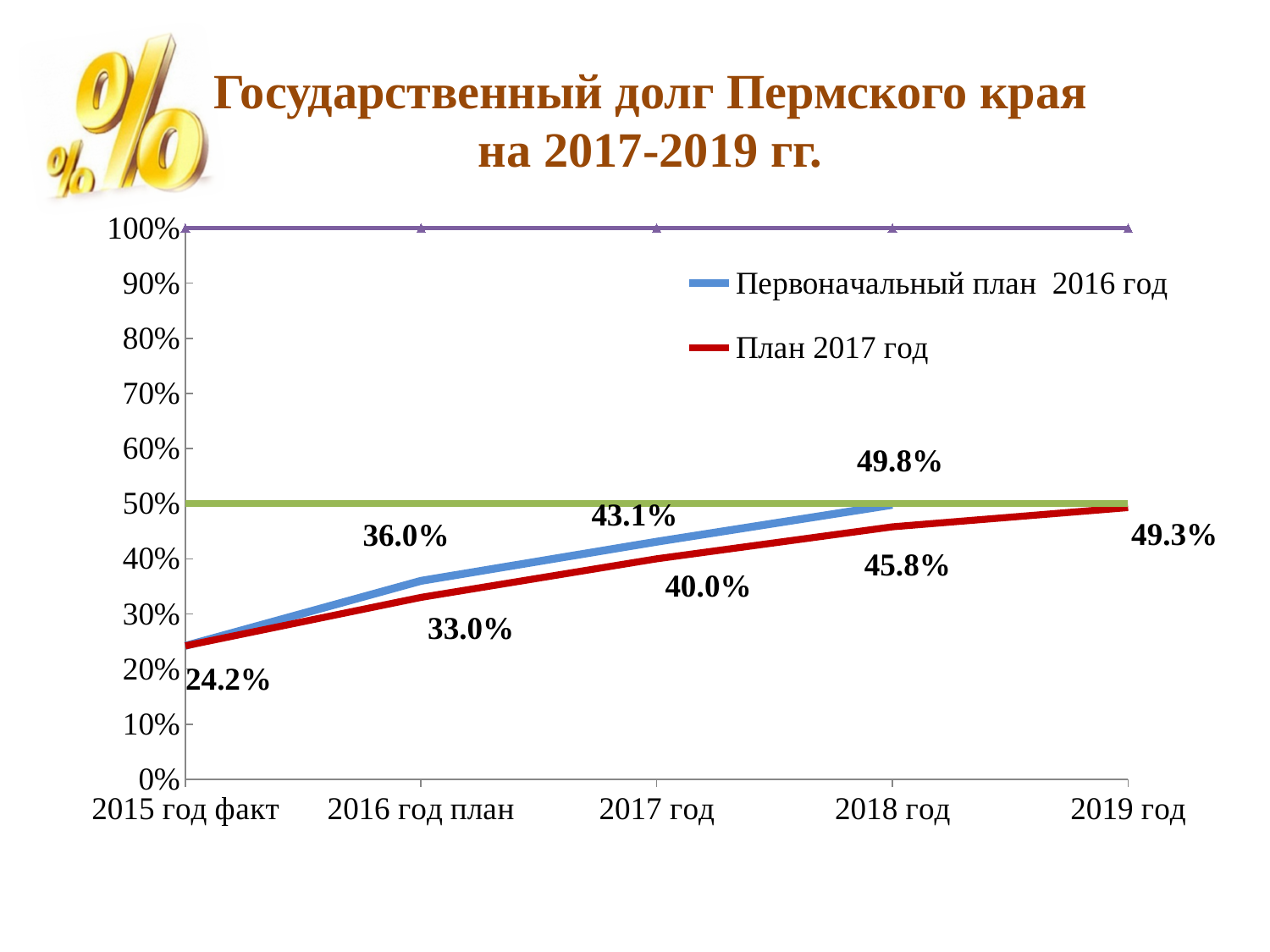
How many series does the legend list? 2 Do the values of the 'План 2017 год' series rise or fall from 2015 год факт to 2019 год? Rise What is the value of the 'План 2017 год' series for 2019 год? 49.3% What is the value of the 'План 2017 год' series for 2017 год? 40.0% What kind of chart is shown on the slide? Line chart What is the value of the 'Первоначальный план 2016 год' series for 2016 год план? 36.0% What is the value of the 'Первоначальный план 2016 год' series for 2018 год? 49.8% How many categories are shown on the x axis? 5 What is the difference between the 'Первоначальный план 2016 год' and 'План 2017 год' values for 2016 год план? 3.0% What is the difference between the 'Первоначальный план 2016 год' and 'План 2017 год' values for 2018 год? 4.0% Which series has the higher value for 2017 год: 'Первоначальный план 2016 год' or 'План 2017 год'? Первоначальный план 2016 год What is the value shown for 2015 год факт? 24.2%